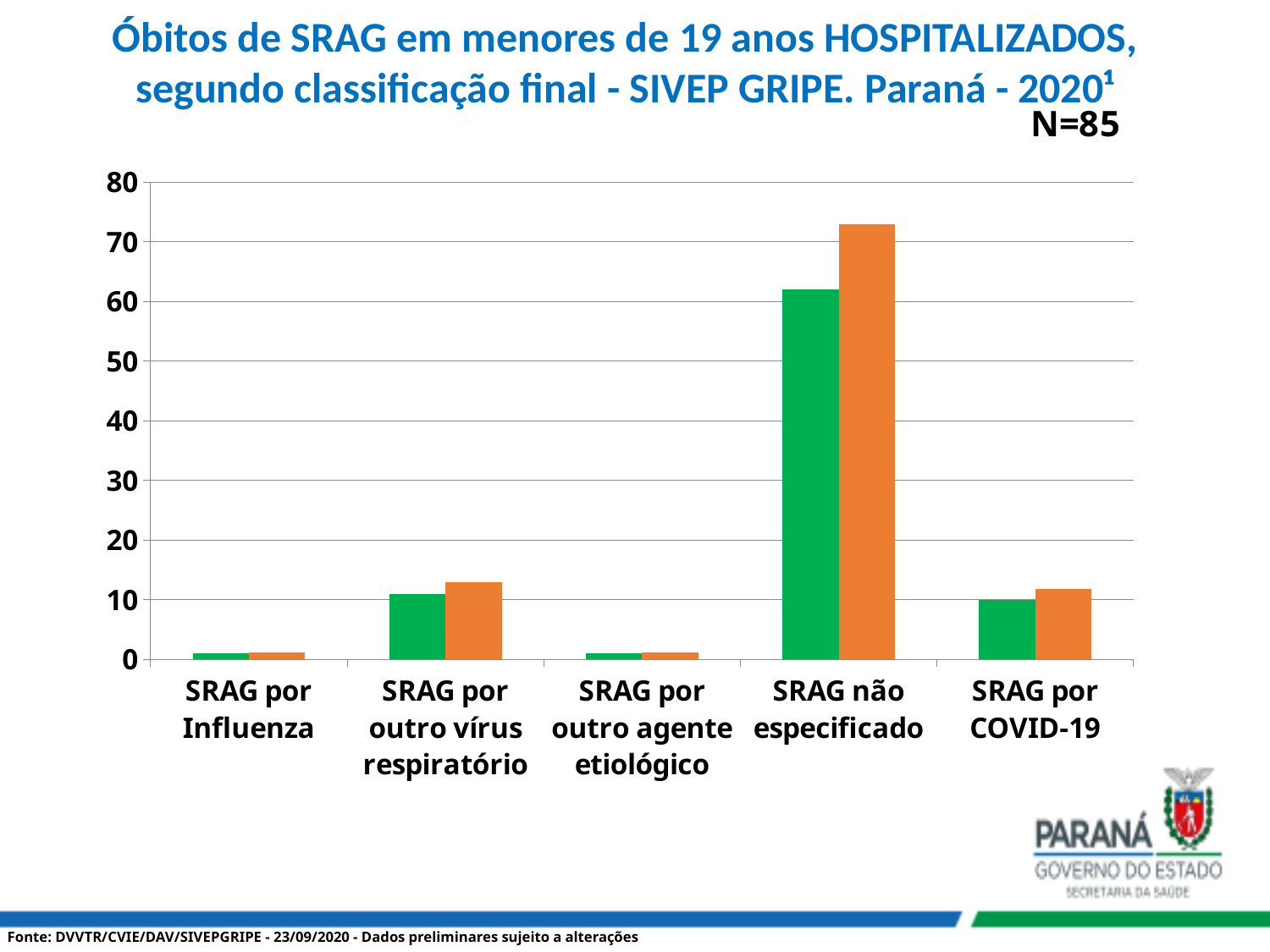
What is the highest value shown on the y axis of the chart? 80 Is the orange bar for SRAG não especificado greater or less than 60? greater For SRAG não especificado, which bar is taller: the green one or the orange one? the orange one What kind of chart is shown on the slide? bar chart Is the orange bar for SRAG por outro vírus respiratório greater or less than 20? less Is the green bar for SRAG por COVID-19 greater or less than 20? less How many categories are shown on the x axis of the chart? 5 Which category has the highest bars in the chart? SRAG não especificado What is the N value shown above the chart? N=85 Which category has larger bars: SRAG por outro vírus respiratório or SRAG por Influenza? SRAG por outro vírus respiratório